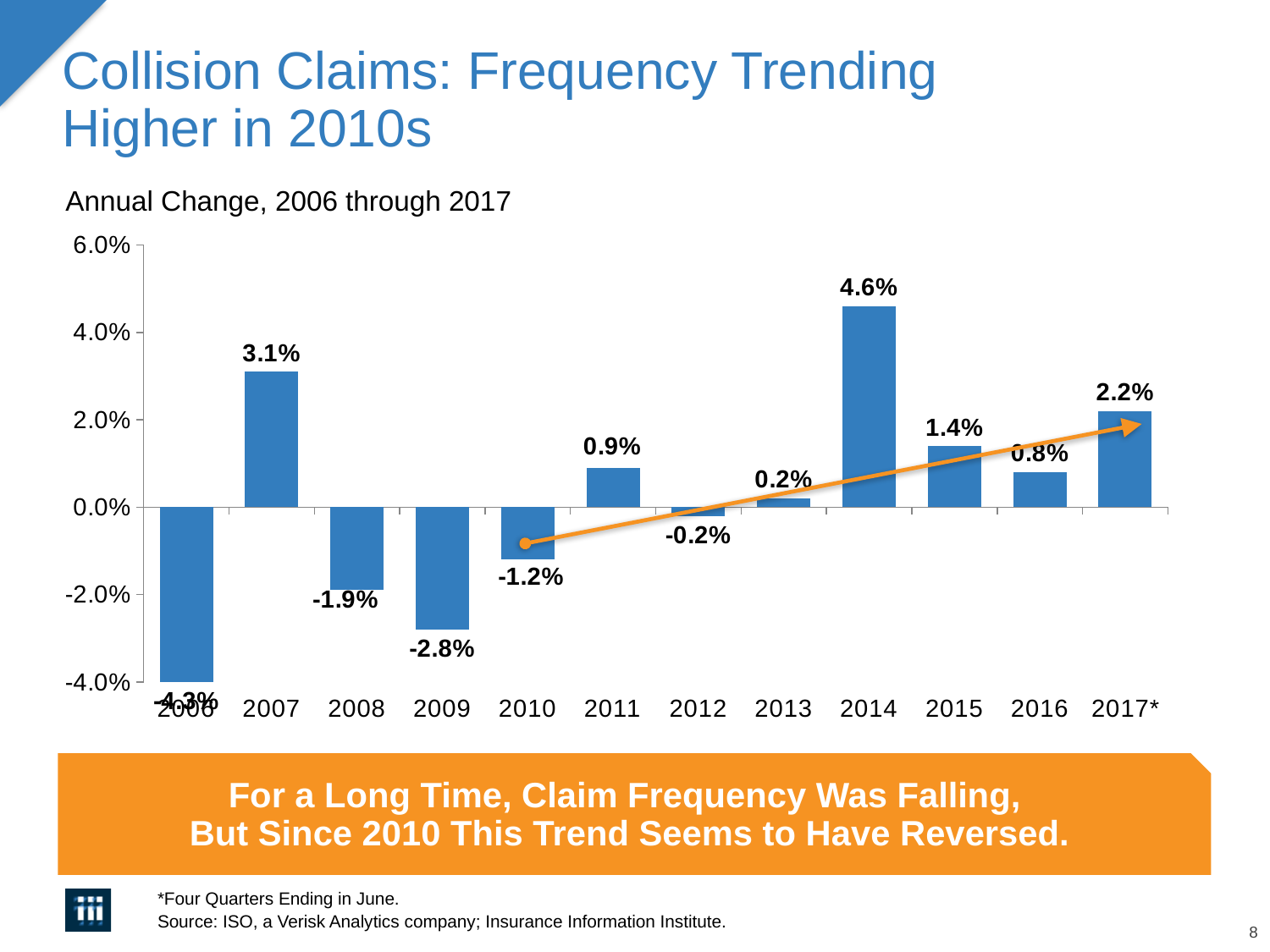
How many years are shown on the x axis? 12 Is the value for 2006 greater or less than -4.0%? less What value is shown for 2017*? 2.2% What kind of chart is shown on the slide? Bar chart Which year has the lowest annual change? 2006 What is the subtitle printed above the chart? Annual Change, 2006 through 2017 What is the annual change in collision claim frequency for 2014? 4.6% What is the annual change shown for 2012? -0.2% Which year has the highest annual change? 2014 What is the difference between the 2014 value and the 2015 value? 3.2 percentage points Which is larger, the value for 2007 or the value for 2017*? 2007 What is the annual change shown for 2009? -2.8%